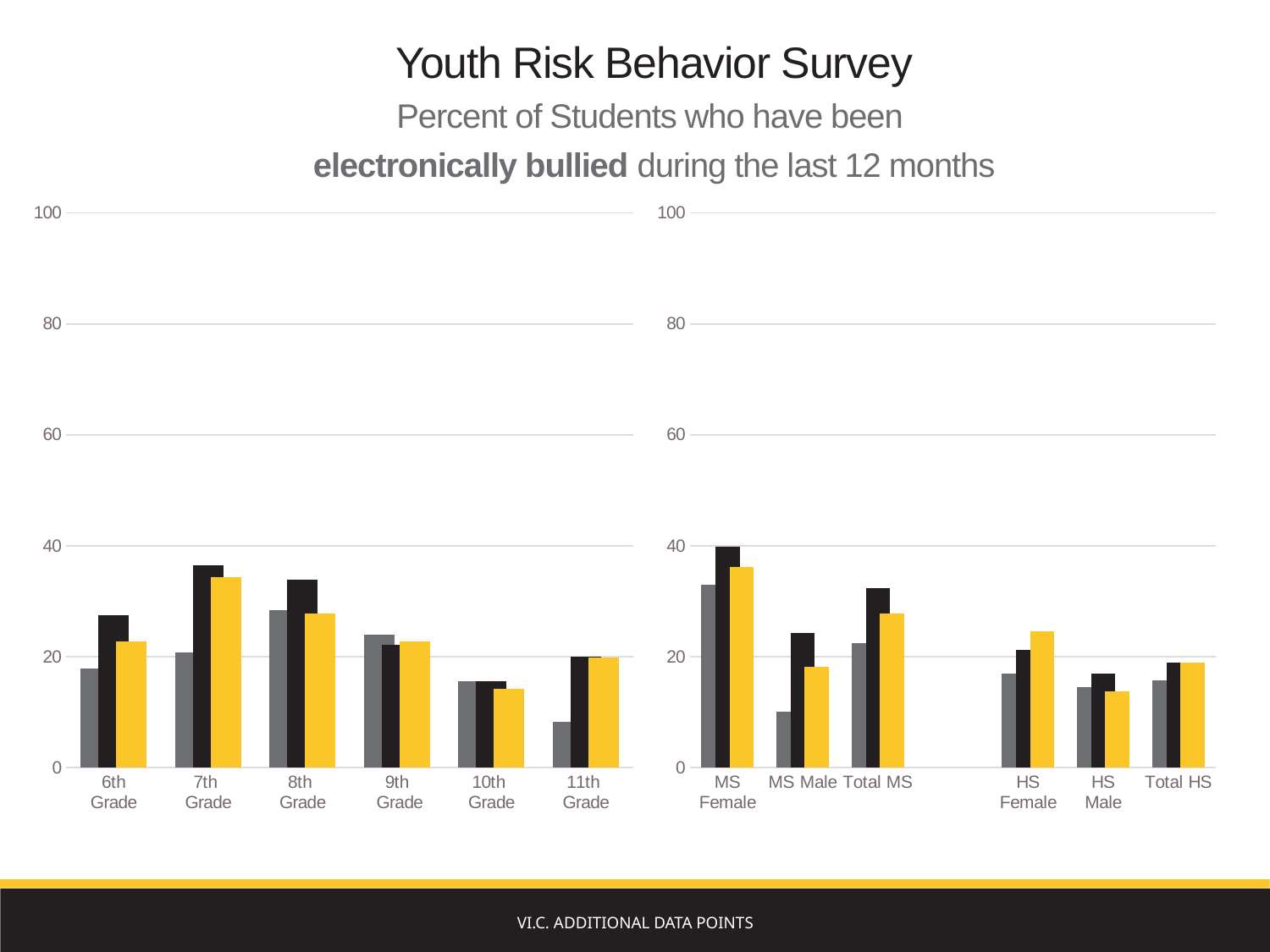
What is the main title shown above the charts on the slide? Youth Risk Behavior Survey On the left chart, which grade has the shortest gray bar? 11th Grade On the left chart, is the gray bar taller for 7th Grade or 10th Grade? 7th Grade What kind of chart is the left chart on the slide? bar chart On the right chart, is the yellow bar taller for HS Female or HS Male? HS Female On the left chart, is the black bar for 7th Grade greater or less than 20? greater On the right chart, which category has the tallest black bar? MS Female On the right chart, is the gray bar for MS Male greater or less than 20? less On the left chart, is the gray bar for 11th Grade greater or less than 20? less How many categories are shown on the right chart? 6 How many grade categories are shown on the left chart? 6